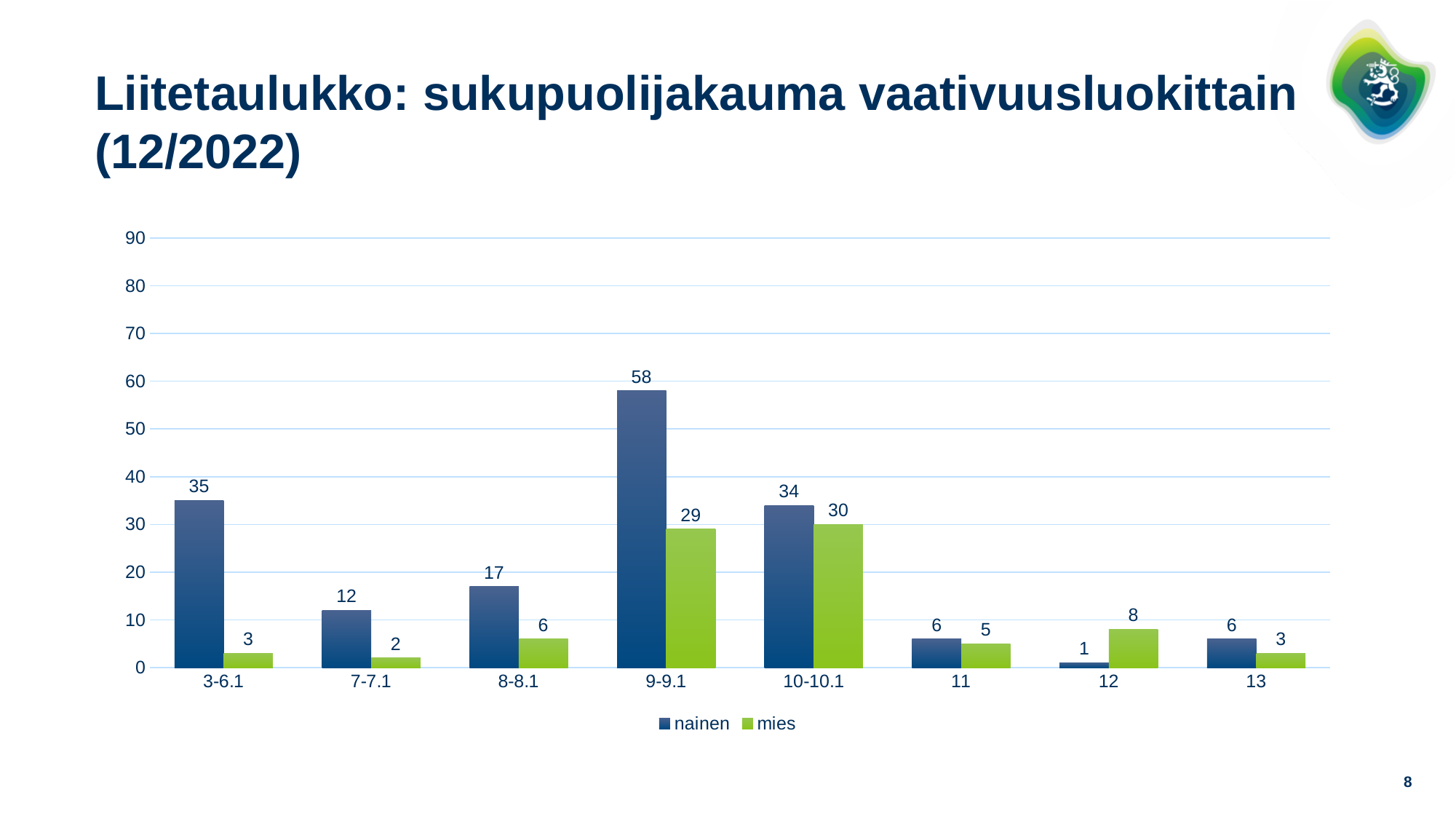
How many categories are shown on the x axis? 8 In category 12, which series has the larger value, nainen or mies? mies Is the value for nainen in category 9-9.1 greater or less than 50? greater Which category has the lowest value for mies? 7-7.1 What is the value for nainen in category 12? 1 What is the value for mies in category 10-10.1? 30 Which category has the highest value for nainen? 9-9.1 What is the value for nainen in category 9-9.1? 58 What kind of chart is shown on the slide? bar chart What is the difference between the nainen and mies values in category 3-6.1? 32 How many series does the legend list? 2 What are the two series named in the legend? nainen and mies